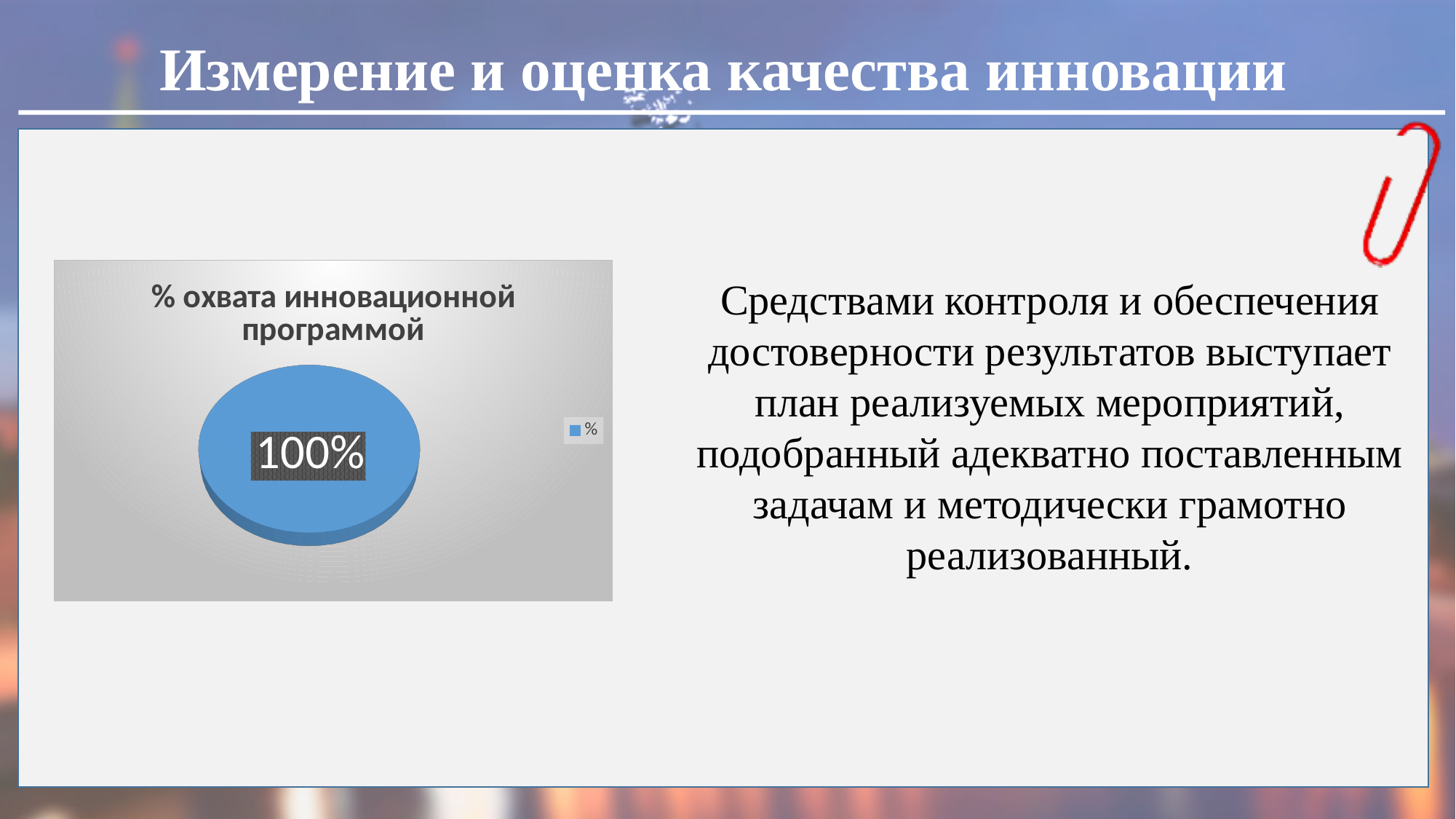
What share of the pie does the single slice occupy? 100% What is the legend entry shown next to the pie chart? % What value is printed on the pie slice? 100% How many slices does the pie chart have? 1 How many entries does the chart legend list? 1 What is the title of the chart? % охвата инновационной программой What type of chart is shown on the slide? pie chart